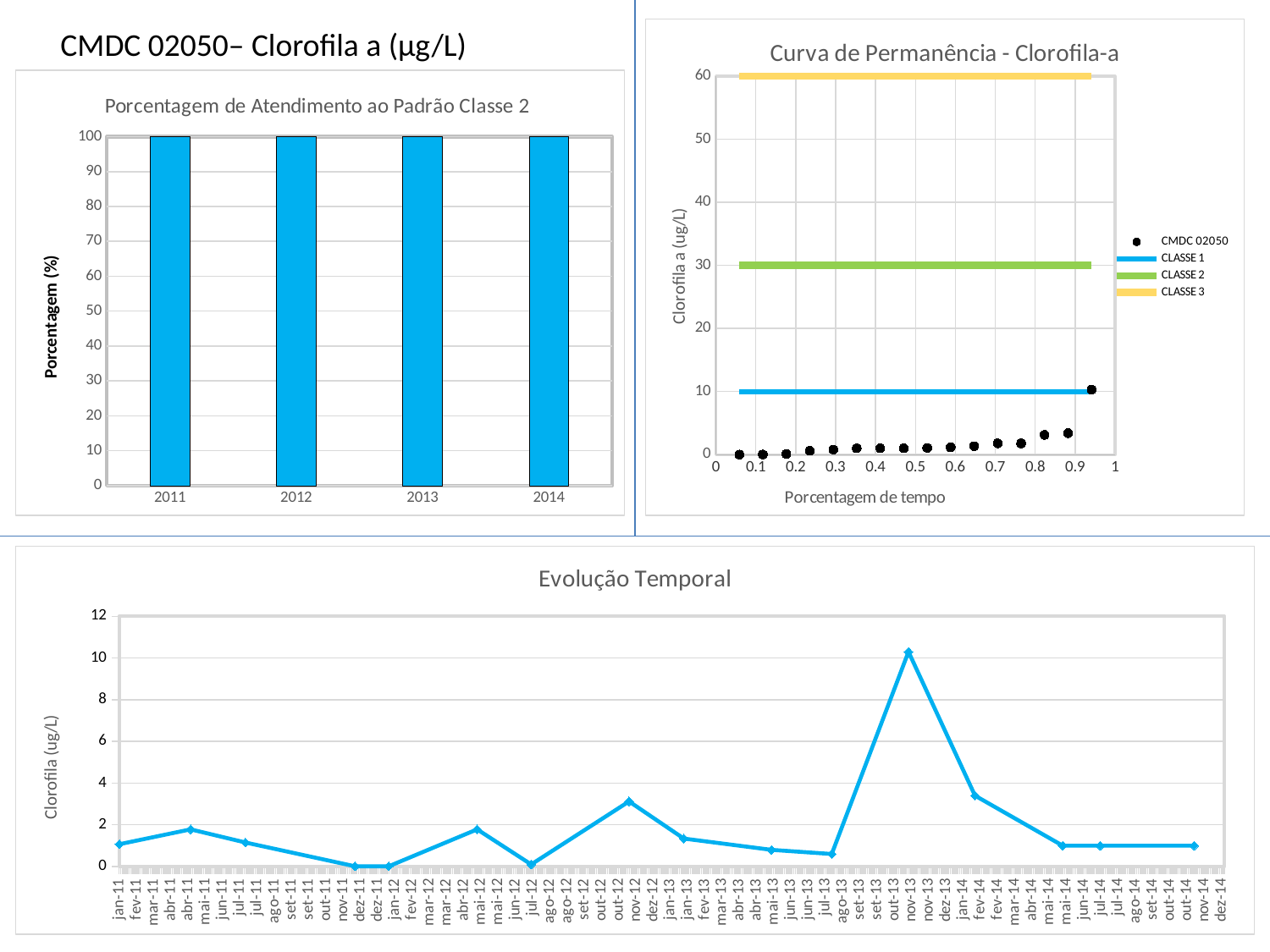
In 'Porcentagem de Atendimento ao Padrão Classe 2', what is the y-axis title? Porcentagem (%) What kind of chart is 'Porcentagem de Atendimento ao Padrão Classe 2'? bar chart In 'Curva de Permanência - Clorofila-a', do the CMDC 02050 points rise or fall along the x axis? rise In 'Evolução Temporal', which month has the highest value? nov-13 In 'Porcentagem de Atendimento ao Padrão Classe 2', what is the value for 2013? 100 In 'Evolução Temporal', is the value for nov-13 greater or less than 8? greater In 'Curva de Permanência - Clorofila-a', at what value is the CLASSE 2 line drawn? 30 In 'Porcentagem de Atendimento ao Padrão Classe 2', how many years are shown on the x axis? 4 How many series does the legend of 'Curva de Permanência - Clorofila-a' list? 4 In 'Evolução Temporal', which is larger, the value for nov-12 or the value for nov-13? nov-13 In 'Curva de Permanência - Clorofila-a', at what value is the CLASSE 3 line drawn? 60 What kind of chart is 'Evolução Temporal'? line chart